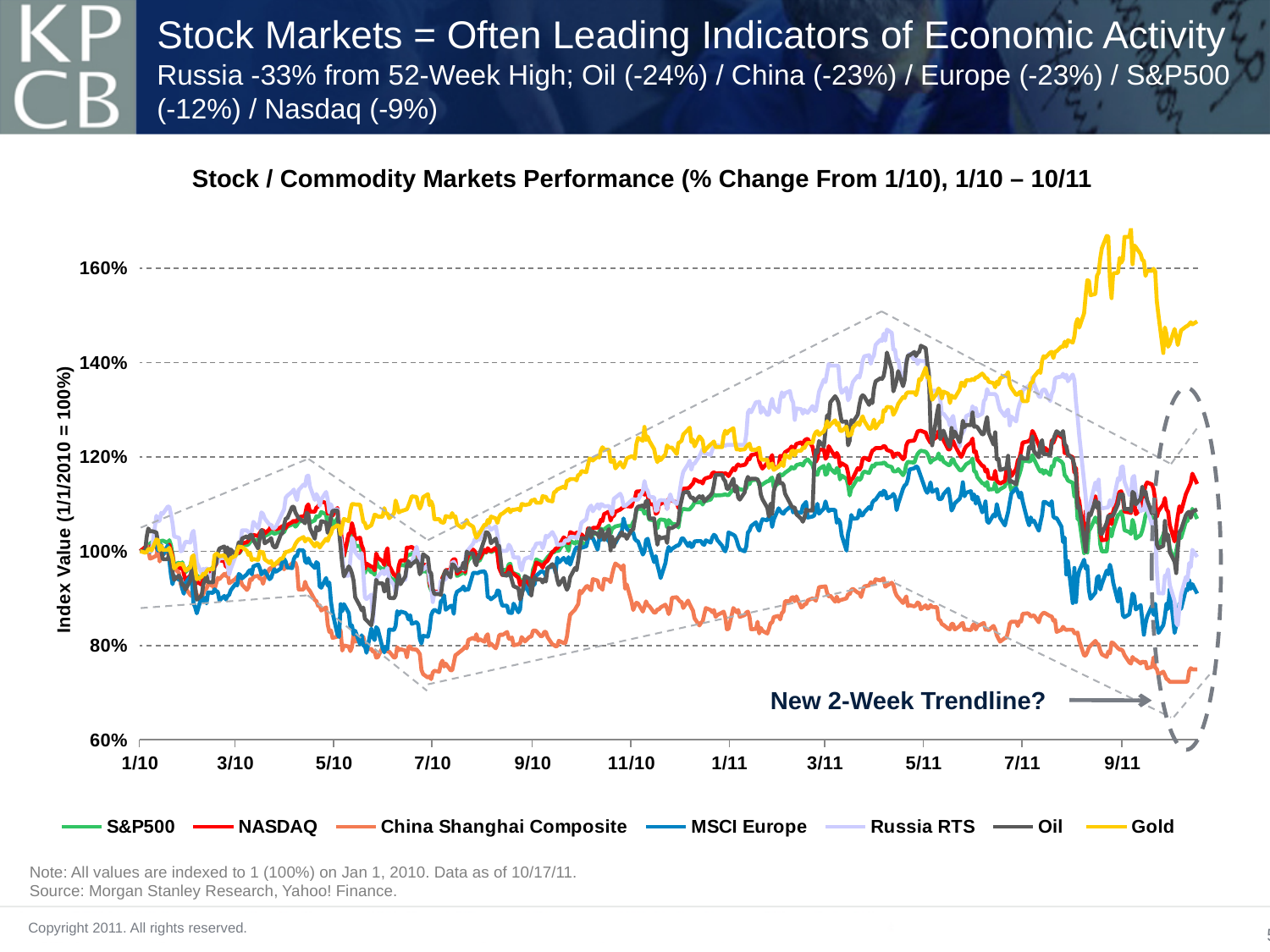
At the end of the chart, which is higher: Gold or MSCI Europe? Gold What is the label of the y axis? Index Value (1/1/2010 = 100%) Is the value of China Shanghai Composite at the end of the chart greater or less than 80%? less What kind of chart is shown on the slide? line chart Which series has the lowest value at the end of the chart (around 10/11)? China Shanghai Composite Is the peak value of Gold greater or less than 160%? greater What is the title of the chart? Stock / Commodity Markets Performance (% Change From 1/10), 1/10 – 10/11 Which series has the highest value at the end of the chart (around 10/11)? Gold How many series does the legend list? 7 Does the China Shanghai Composite line overall rise or fall from 1/10 to 10/11? fall Does the Gold line overall rise or fall from 1/10 to 10/11? rise Is the value of Russia RTS at its peak around 4/11 greater or less than 140%? greater